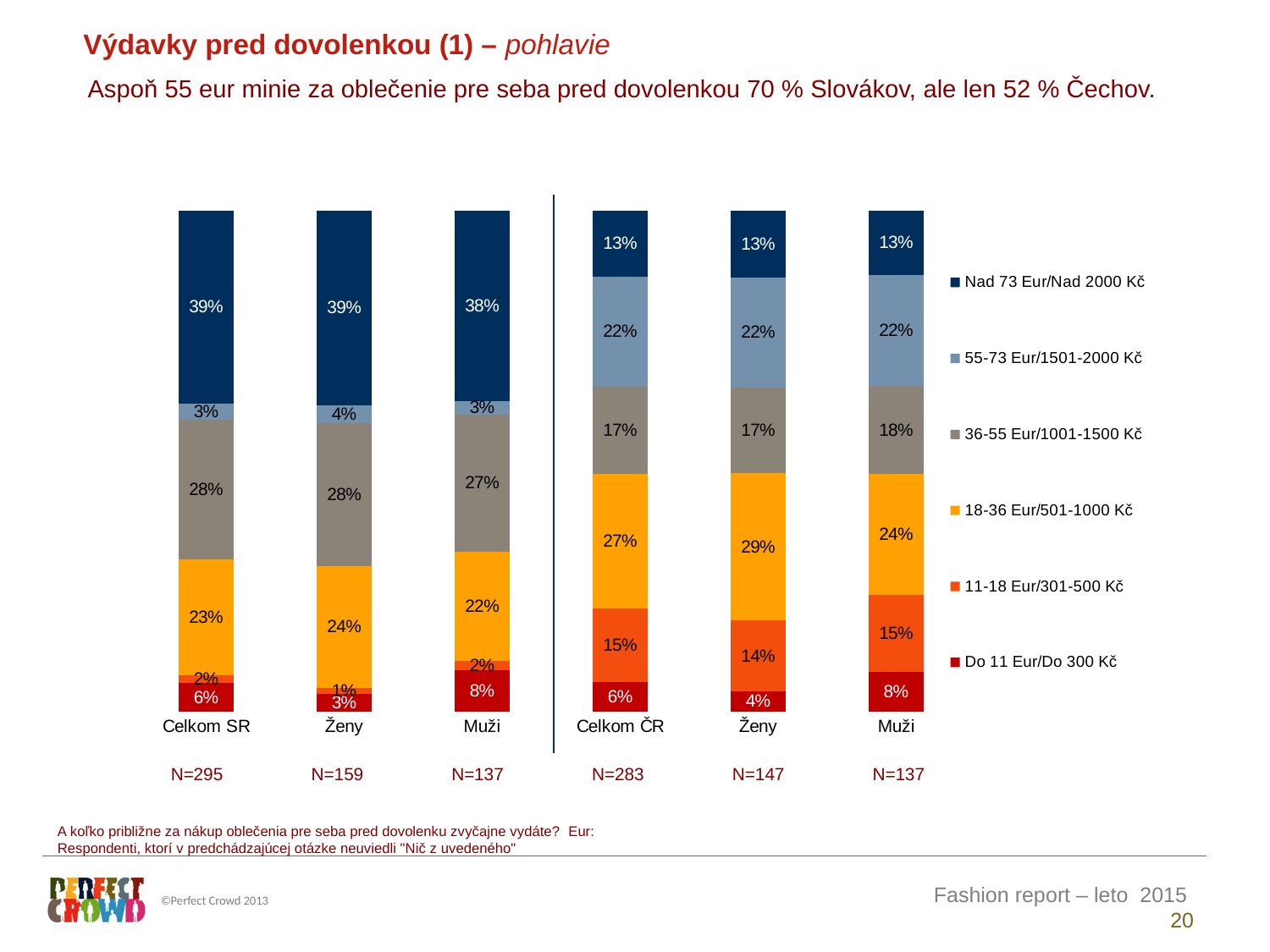
In the ČR group, which bar has the lowest 'Do 11 Eur/Do 300 Kč' value? Ženy In the ČR group, what is the difference in the '18-36 Eur/501-1000 Kč' segment between Ženy and Muži? 5 percentage points In the ČR group, which bar has the highest '18-36 Eur/501-1000 Kč' value? Ženy How many bars are shown in the chart? 6 What percentage of Celkom SR falls in the 'Nad 73 Eur/Nad 2000 Kč' category? 39% Which has a larger 'Nad 73 Eur/Nad 2000 Kč' share, Celkom SR or Celkom ČR? Celkom SR For Muži in the ČR group (right side), what is the value of the '18-36 Eur/501-1000 Kč' segment? 24% For Ženy in the SR group (left side), what is the value of the '36-55 Eur/1001-1500 Kč' segment? 28% What is the value of the '55-73 Eur/1501-2000 Kč' segment for Celkom ČR? 22% How many series does the legend list? 6 What type of chart is shown on the slide? Stacked bar chart What is the value of the '11-18 Eur/301-500 Kč' segment for Celkom ČR? 15%